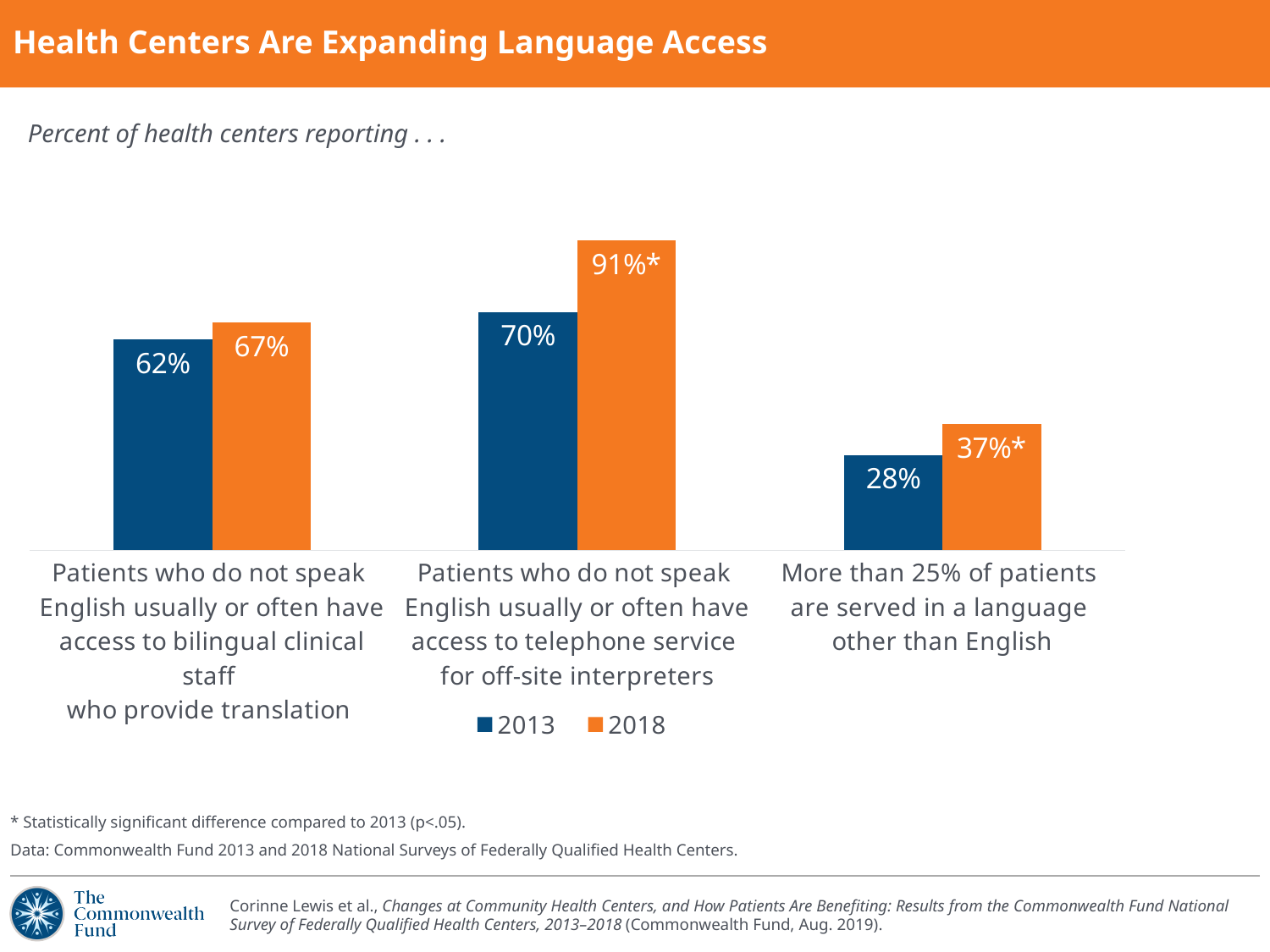
What is the difference between the 2018 and 2013 values for more than 25% of patients served in a language other than English? 9 percentage points Is the 2018 value for access to bilingual clinical staff larger or smaller than the 2013 value? larger Which category has the lowest 2013 value? More than 25% of patients are served in a language other than English What was the 2013 value for patients who do not speak English usually or often having access to bilingual clinical staff who provide translation? 62% What percentage of health centers reported in 2013 that more than 25% of patients are served in a language other than English? 28% What percentage of health centers reported in 2018 that patients who do not speak English usually or often have access to telephone service for off-site interpreters? 91% How many categories are shown on the x axis? 3 Which category has the highest 2018 value? Patients who do not speak English usually or often have access to telephone service for off-site interpreters How many series does the legend list? 2 What kind of chart is shown on the slide? bar chart By how many percentage points did access to telephone service for off-site interpreters increase from 2013 to 2018? 21 percentage points Which years are listed in the legend? 2013 and 2018